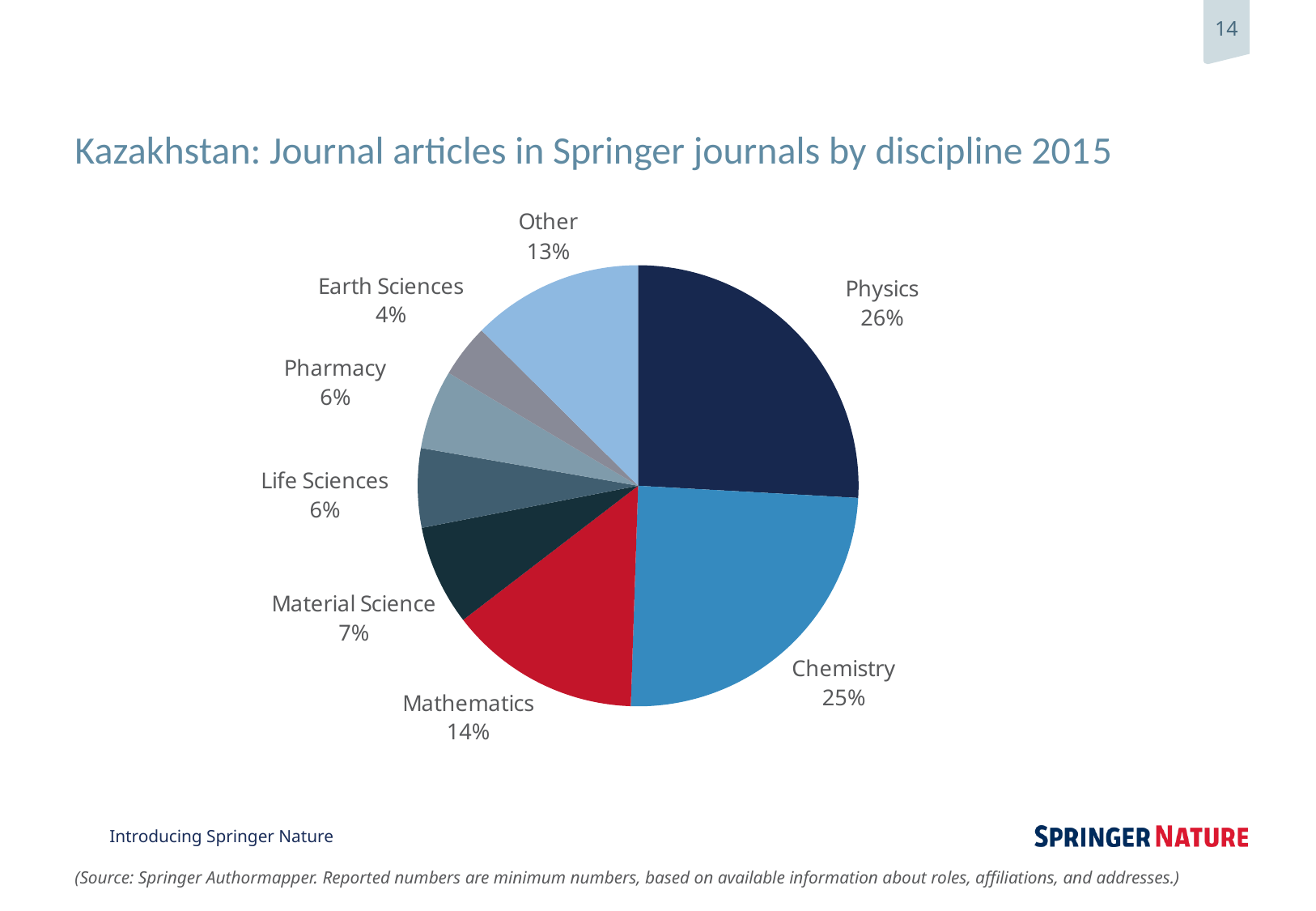
What share does Earth Sciences have in the pie chart? 4% Which has a larger share, Material Science or Pharmacy? Material Science Which has a larger share, Other or Mathematics? Mathematics Which discipline has the largest share of the pie? Physics Which discipline has the smallest share of the pie? Earth Sciences What share of Kazakhstan's journal articles in Springer journals in 2015 is in Physics? 26% What percentage of the pie is Mathematics? 14% What is the difference in percentage points between Physics and Chemistry? 1 What is the difference in percentage points between Mathematics and Material Science? 7 What is the title of the chart? Kazakhstan: Journal articles in Springer journals by discipline 2015 How many slices does the pie chart have? 8 What kind of chart is shown on the slide? Pie chart